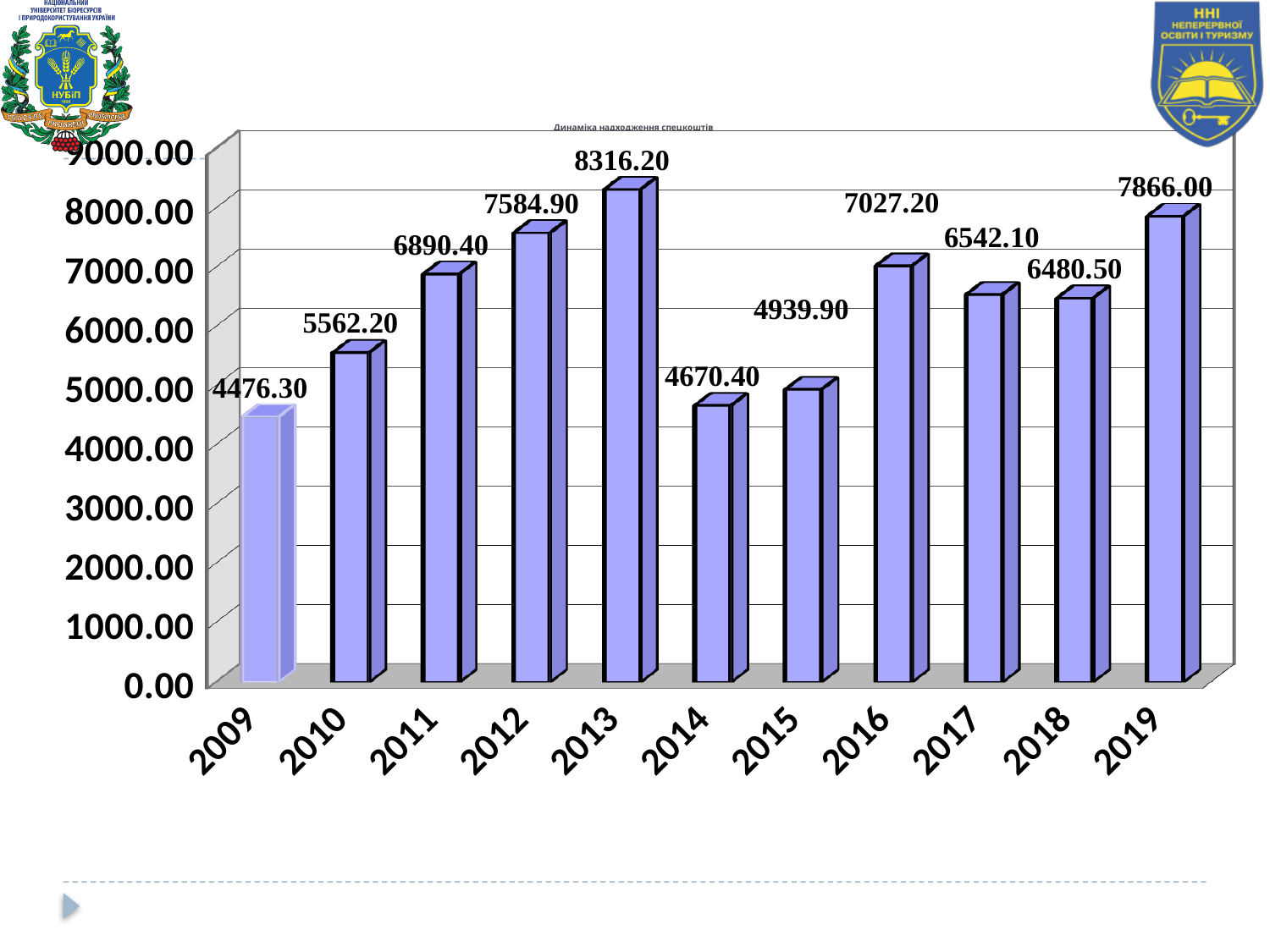
What is the value for 2019? 7866.00 What kind of chart is shown on the slide? bar chart What is the difference between the values for 2013 and 2014? 3645.80 What is the difference between the values for 2019 and 2018? 1385.50 Is the value for 2015 greater or less than 5000.00? less Do the values rise or fall from 2009 to 2013? rise Which year has the highest value? 2013 What is the value for 2013? 8316.20 Which is larger, the value for 2016 or the value for 2017? 2016 What is the value for 2009? 4476.30 How many years are shown on the x axis? 11 Which year has the lowest value? 2009